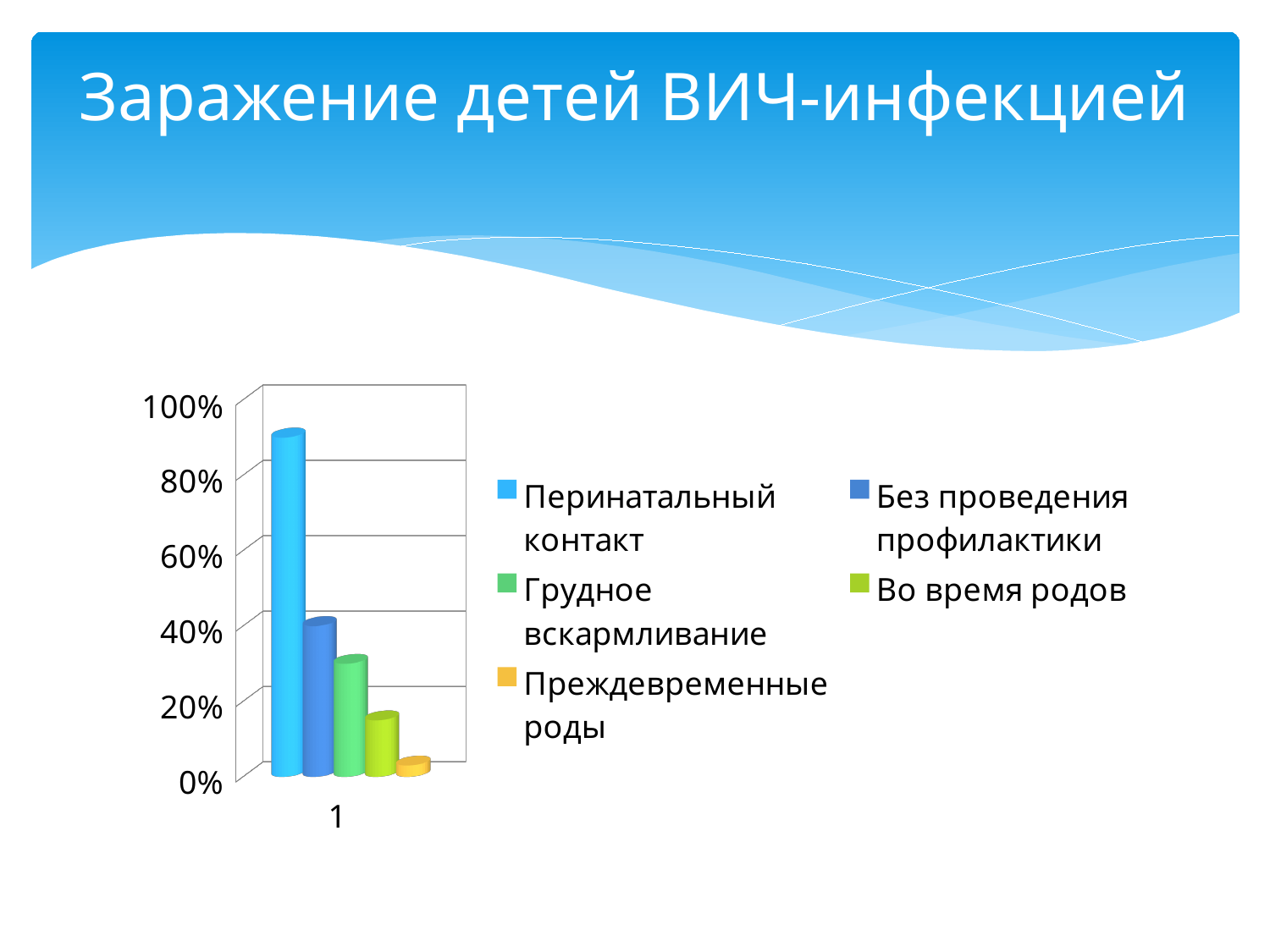
Which series has the lowest value? Преждевременные роды How many series does the legend list? 5 What is the title of the slide containing the chart? Заражение детей ВИЧ-инфекцией Which is larger, the value for Без проведения профилактики or the value for Во время родов? Без проведения профилактики Is the value for Грудное вскармливание greater or less than 40%? less Is the value for Во время родов greater or less than 20%? less Is the value for Без проведения профилактики greater or less than 20%? greater What kind of chart is shown on the slide? bar chart Which series has the highest value? Перинатальный контакт How many categories are shown on the x axis? 1 Which is larger, the value for Грудное вскармливание or the value for Преждевременные роды? Грудное вскармливание